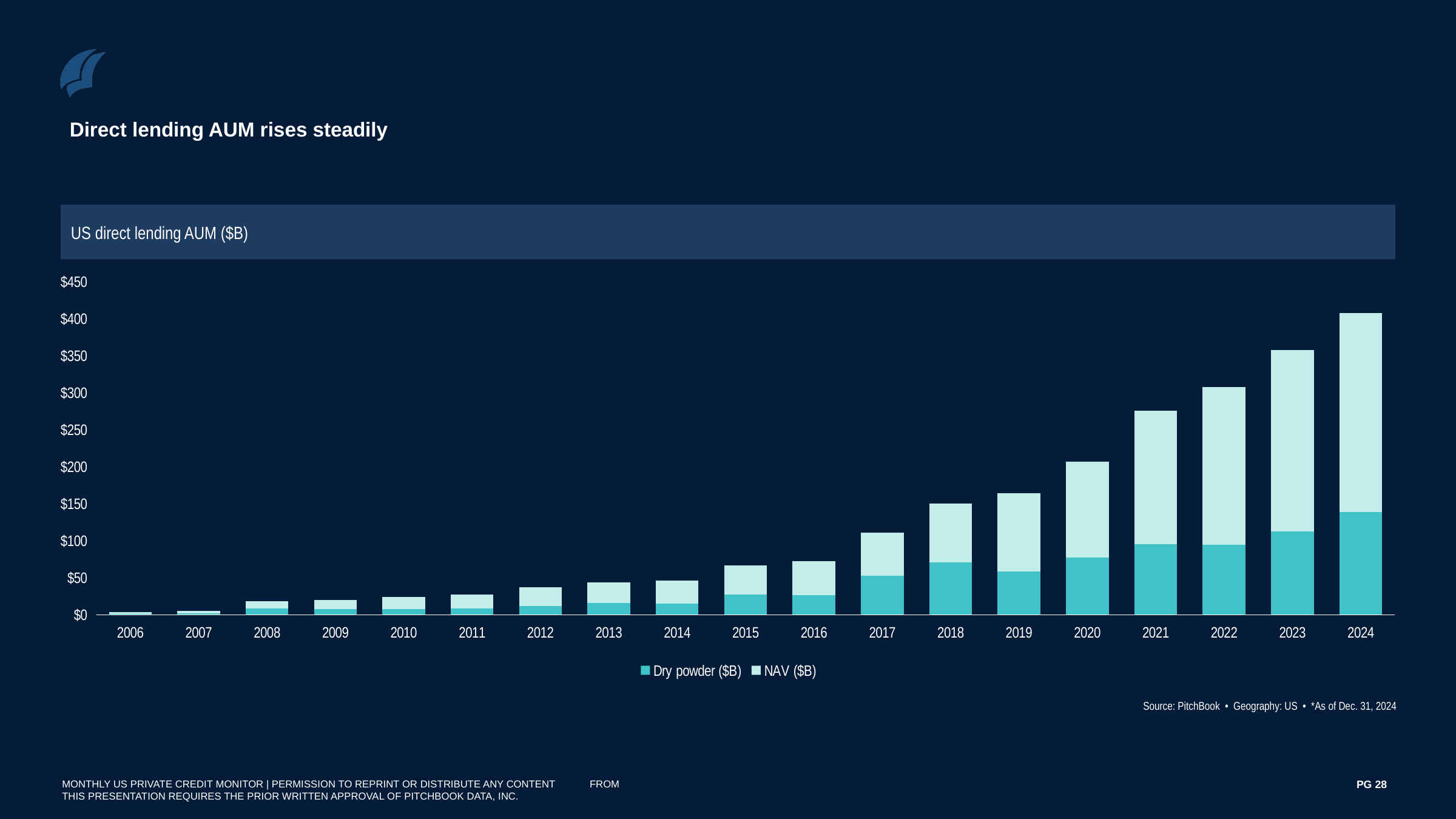
Is the total AUM for 2017 greater or less than $100? greater How many series does the legend list? 2 What is the title of the chart? US direct lending AUM ($B) How many years are shown along the x axis? 19 Is the total AUM for 2021 greater or less than $250? greater Do total AUM values rise or fall from 2006 to 2024? Rise Which year has the highest total direct lending AUM? 2024 What kind of chart is shown on the slide? Stacked bar chart Is the total AUM for 2024 greater or less than $400? greater Which year has the larger Dry powder value, 2018 or 2019? 2018 Which year has the lowest total direct lending AUM? 2006